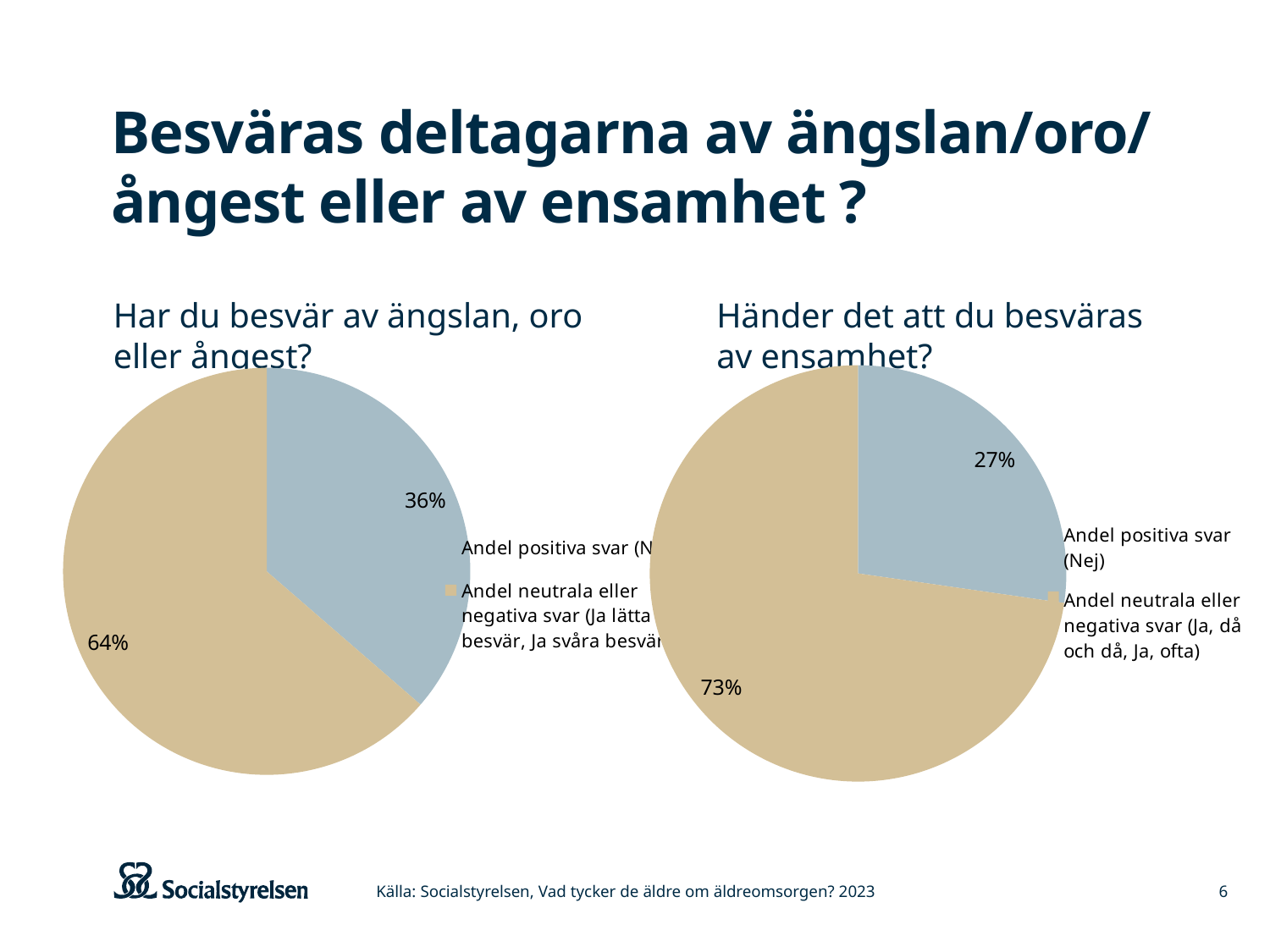
Is the 'Andel positiva svar' share larger in the left chart 'Har du besvär av ängslan, oro eller ångest?' or in the right chart 'Händer det att du besväras av ensamhet?'? Left chart (36%) In the right chart 'Händer det att du besväras av ensamhet?', what is the difference in percentage points between the two slices? 46 In the right chart 'Händer det att du besväras av ensamhet?', what share is labelled for 'Andel positiva svar (Nej)'? 27% In the left chart 'Har du besvär av ängslan, oro eller ångest?', what share is labelled for the 'Andel neutrala eller negativa svar' slice? 64% In the left chart 'Har du besvär av ängslan, oro eller ångest?', which slice is the largest? Andel neutrala eller negativa svar What type of chart is used for 'Händer det att du besväras av ensamhet?'? Pie chart In the left chart 'Har du besvär av ängslan, oro eller ångest?', what share is labelled for the 'Andel positiva svar' slice? 36% In the right chart 'Händer det att du besväras av ensamhet?', what share is labelled for 'Andel neutrala eller negativa svar (Ja, då och då, Ja, ofta)'? 73% In the left chart 'Har du besvär av ängslan, oro eller ångest?', what is the difference in percentage points between the two slices? 28 How many slices does the left chart 'Har du besvär av ängslan, oro eller ångest?' have? 2 In the right chart 'Händer det att du besväras av ensamhet?', which slice is the smallest? Andel positiva svar (Nej) In the right chart 'Händer det att du besväras av ensamhet?', what colour is the 'Andel positiva svar (Nej)' slice? Blue-grey